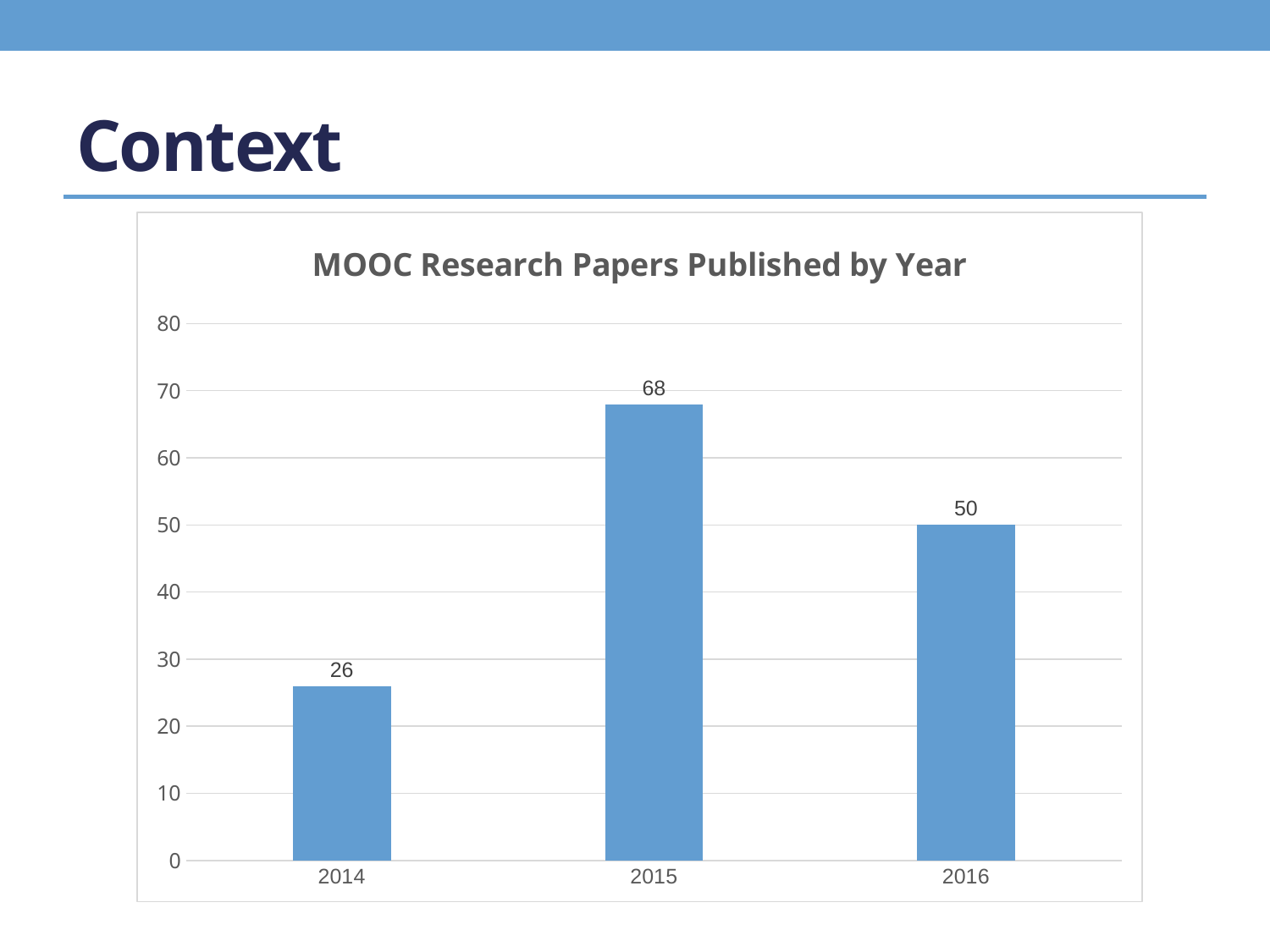
How many MOOC research papers were published in 2015? 68 What is the title of the chart? MOOC Research Papers Published by Year Which year had the lowest number of MOOC research papers published? 2014 How many MOOC research papers were published in 2016? 50 How many years are shown on the x axis of the chart? 3 What is the difference between the number of papers published in 2015 and in 2014? 42 Is the value for 2015 greater or less than 60? greater What is the difference between the number of papers published in 2015 and in 2016? 18 Which year had the highest number of MOOC research papers published? 2015 How many MOOC research papers were published in 2014? 26 Which year had more papers published, 2014 or 2016? 2016 What kind of chart is shown on the slide? Bar chart